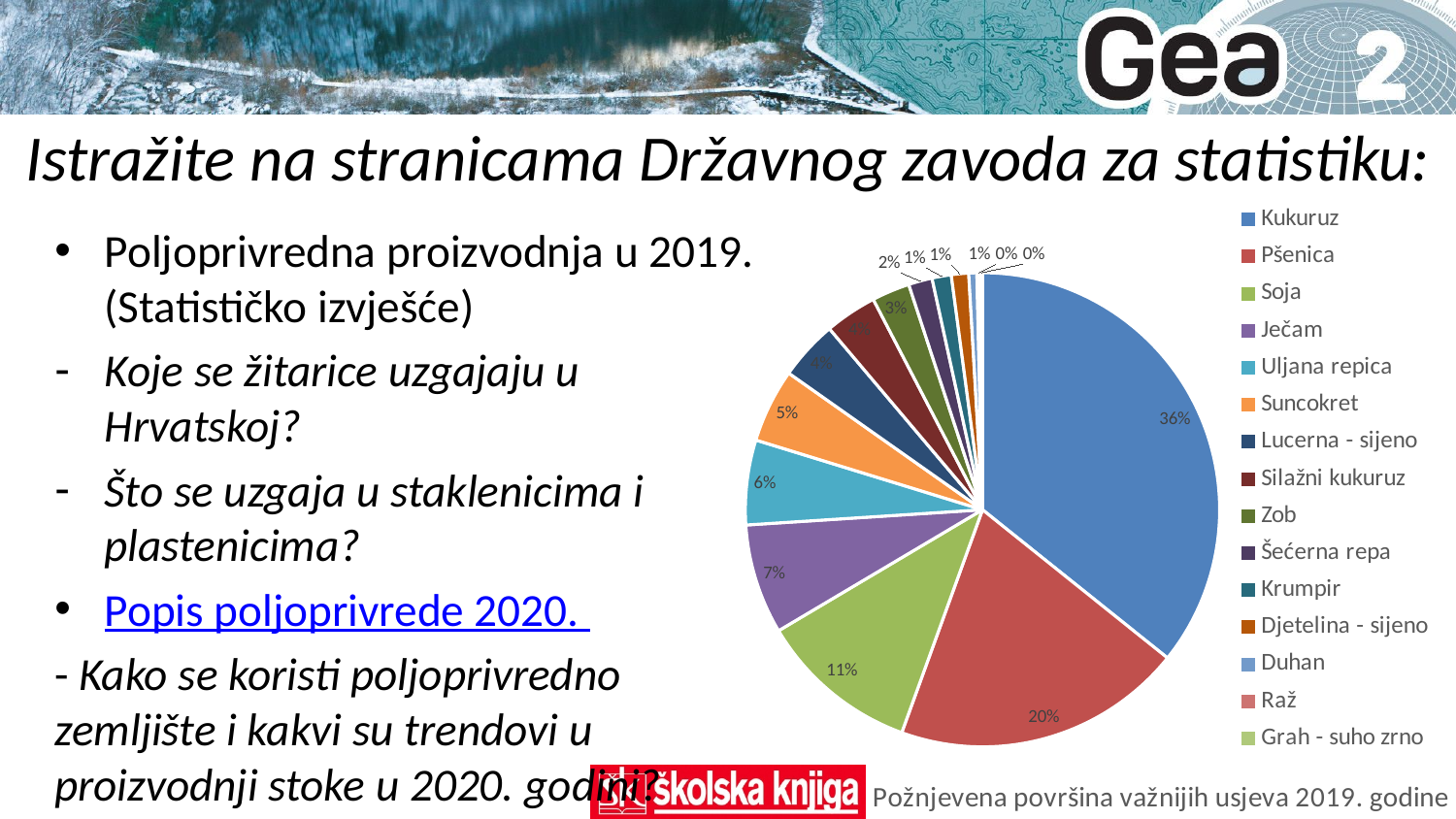
What share of the pie does Kukuruz have? 36% What is the difference in percentage points between the Kukuruz share and the Pšenica share? 16 What share of the pie does Pšenica have? 20% Which is larger, the share for Pšenica or the share for Soja? Pšenica What share of the pie does Uljana repica have? 6% What is the title of the pie chart? Požnjevena površina važnijih usjeva 2019. godine How many entries does the legend of the pie chart list? 15 Which crop has the largest slice of the pie? Kukuruz What kind of chart is shown on the slide? pie chart